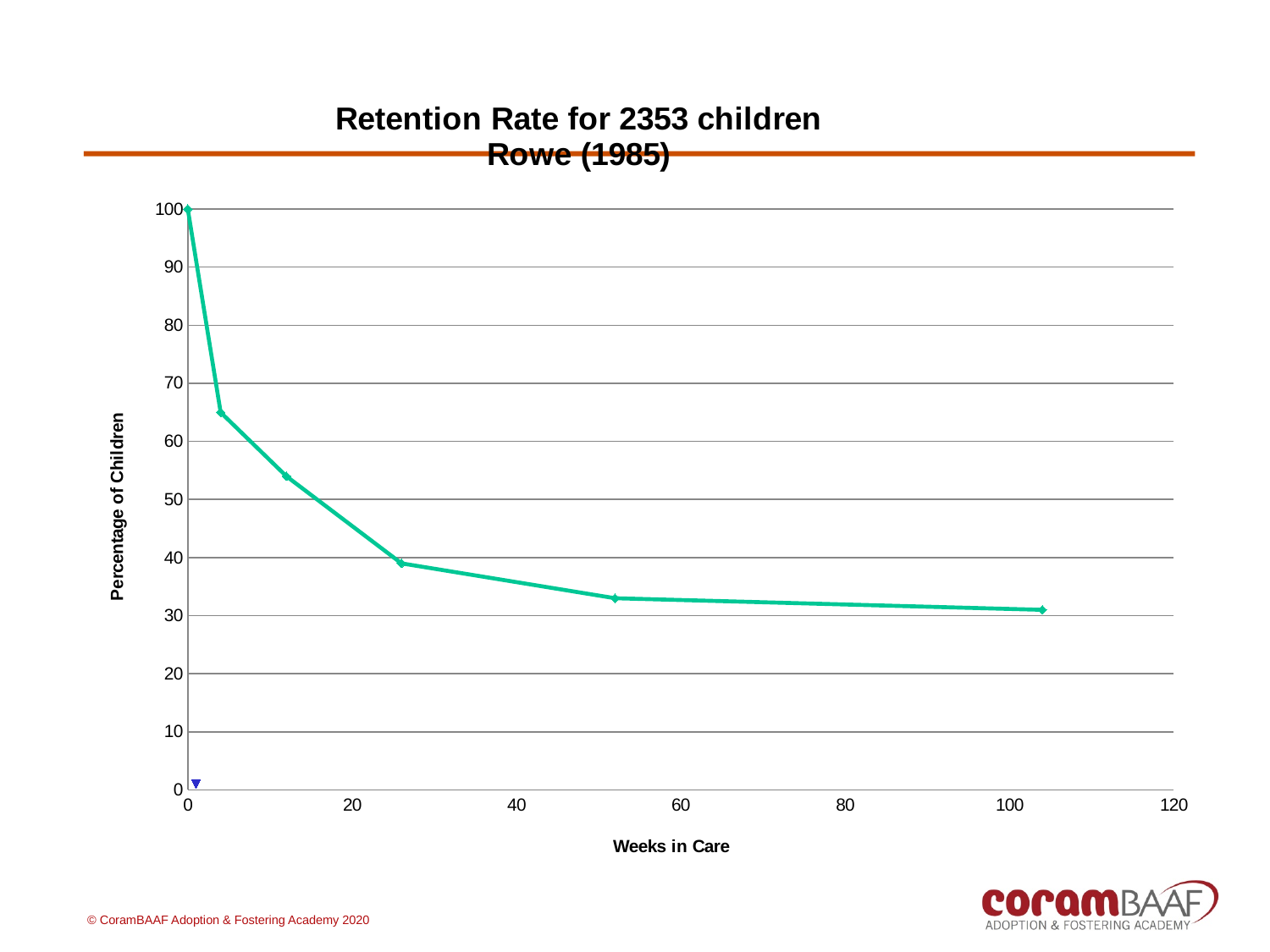
What kind of chart is shown on the slide? line chart At how many weeks in care is the percentage of children highest? 0 What is the title of the chart? Retention Rate for 2353 children Rowe (1985) Is the percentage of children at around 4 weeks in care greater or less than 60? greater Which is larger: the percentage of children at 0 weeks or at around 26 weeks in care? 0 weeks Is the percentage of children at around 52 weeks in care greater or less than 40? less What is the percentage of children at 0 weeks in care? 100 How many data points are plotted on the line? 6 Do the values rise or fall as weeks in care increase? fall What is the label of the x axis? Weeks in Care Is the percentage of children at around 12 weeks in care greater or less than 50? greater